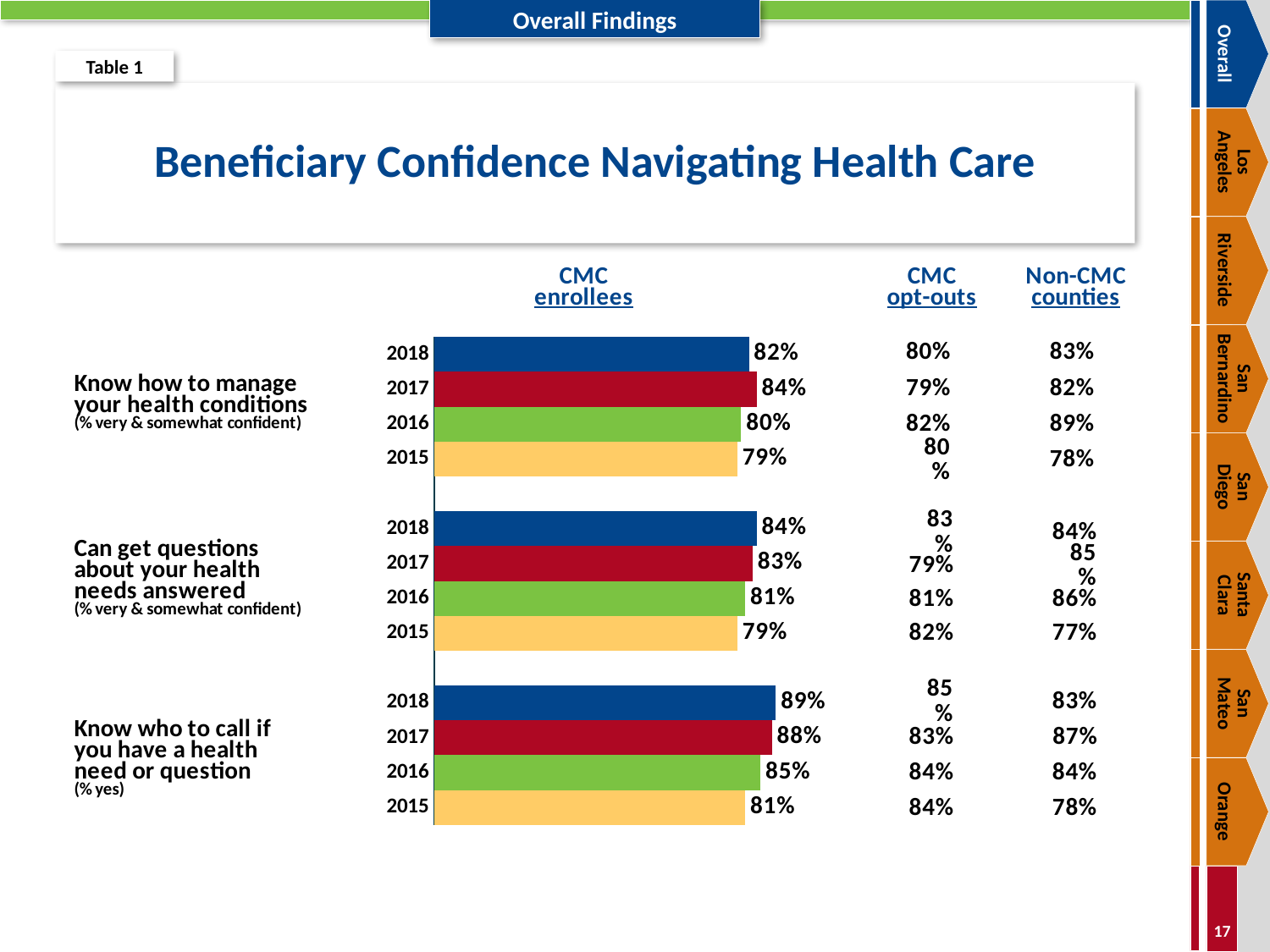
How many bars are plotted in total across the three question groups? 12 What is the CMC enrollees value for 2015 for 'Can get questions about your health needs answered'? 79% What is the CMC enrollees value for 2017 for 'Know who to call if you have a health need or question'? 88% What kind of chart is used to show the CMC enrollees values on this slide? Bar chart What is the title of the chart on this slide? Beneficiary Confidence Navigating Health Care For 'Know who to call if you have a health need or question', do the CMC enrollees values rise or fall from 2015 to 2018? Rise Which year has the highest CMC enrollees value for 'Know who to call if you have a health need or question'? 2018 For 'Know how to manage your health conditions', which year has the larger CMC enrollees value, 2017 or 2016? 2017 Which year has the lowest CMC enrollees value for 'Know how to manage your health conditions'? 2015 What colour are the bars for 2018? Blue What is the CMC enrollees value for 2018 for 'Know how to manage your health conditions'? 82% What is the difference between the 2018 and 2015 CMC enrollees values for 'Know who to call if you have a health need or question'? 8%